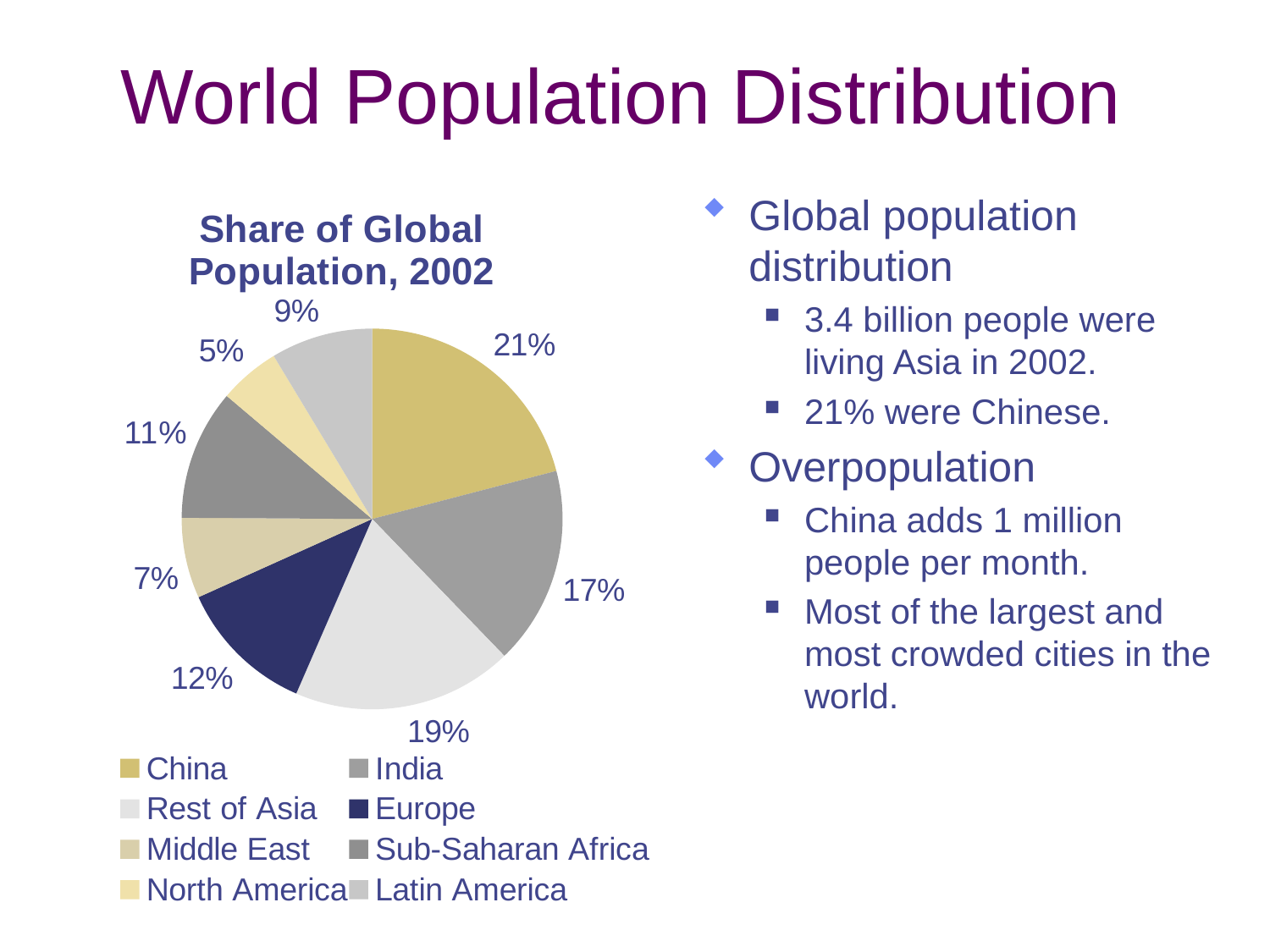
What is the title of the chart? Share of Global Population, 2002 Which region has the smallest share in the pie chart? North America How many regions are shown in the pie chart? 8 What share of global population does India have in the pie chart? 17% Which has a larger share, Latin America or Middle East? Latin America What share of global population does North America have in the pie chart? 5% What share of global population does China have in the pie chart? 21% What share of global population does Sub-Saharan Africa have in the pie chart? 11% What is the difference in percentage points between the shares of Rest of Asia and Europe? 7 Which region has the largest share in the pie chart? China What share of global population does Europe have in the pie chart? 12% What type of chart is shown on the slide? Pie chart